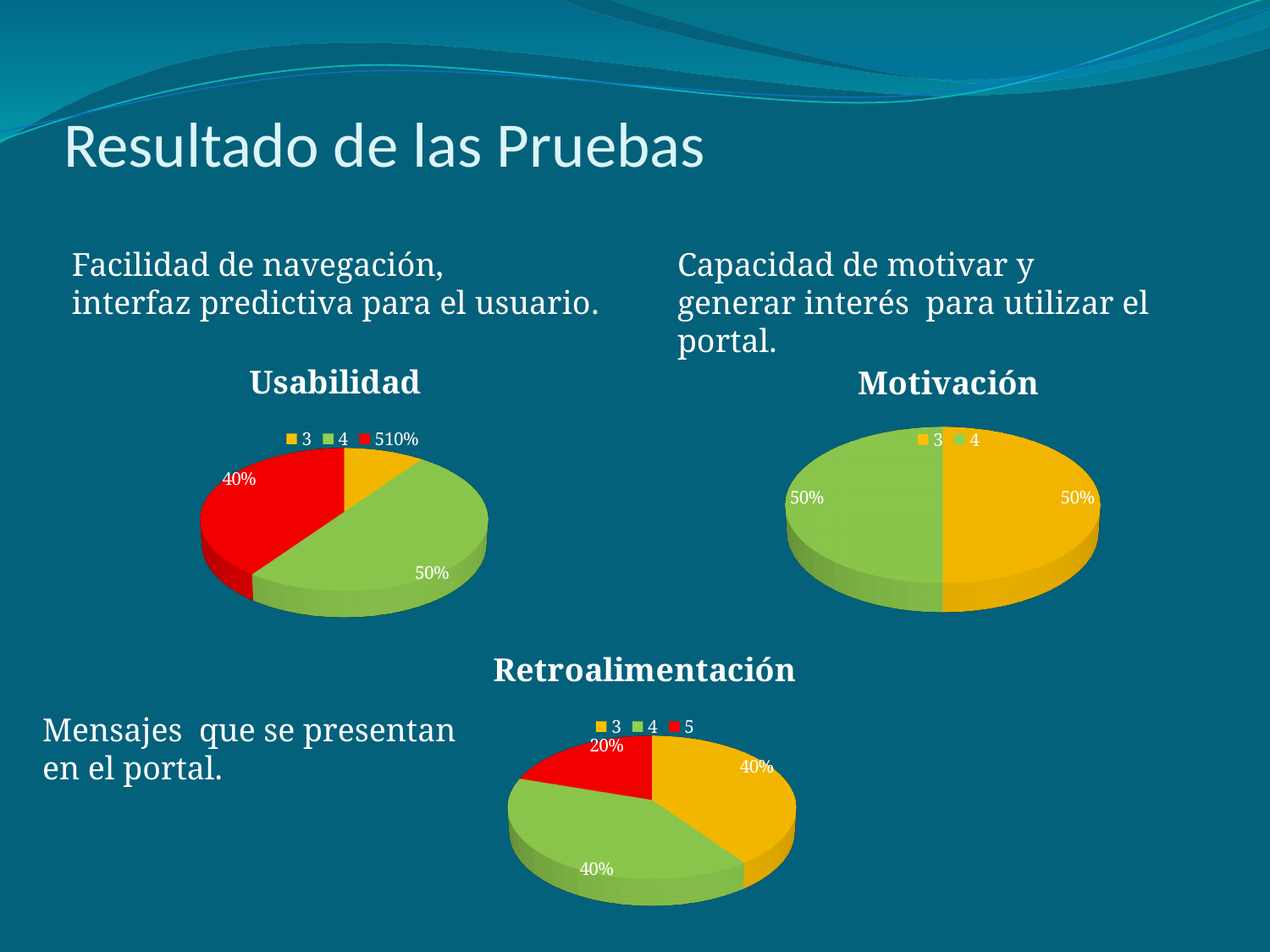
In the Retroalimentación chart, what share does category 3 have? 40% In the Retroalimentación chart, which category has the smallest slice? 5 In the Usabilidad chart, what share does category 5 have? 40% How many slices does the Retroalimentación pie chart have? 3 In the Retroalimentación chart, what is the difference between the shares of category 4 and category 5? 20% In the Usabilidad chart, which category has the smallest slice? 3 In the Motivación chart, what share does category 3 have? 50% What type of chart is the Usabilidad chart? pie chart How many series does the legend of the Motivación chart list? 2 In the Usabilidad chart, which category has the largest slice? 4